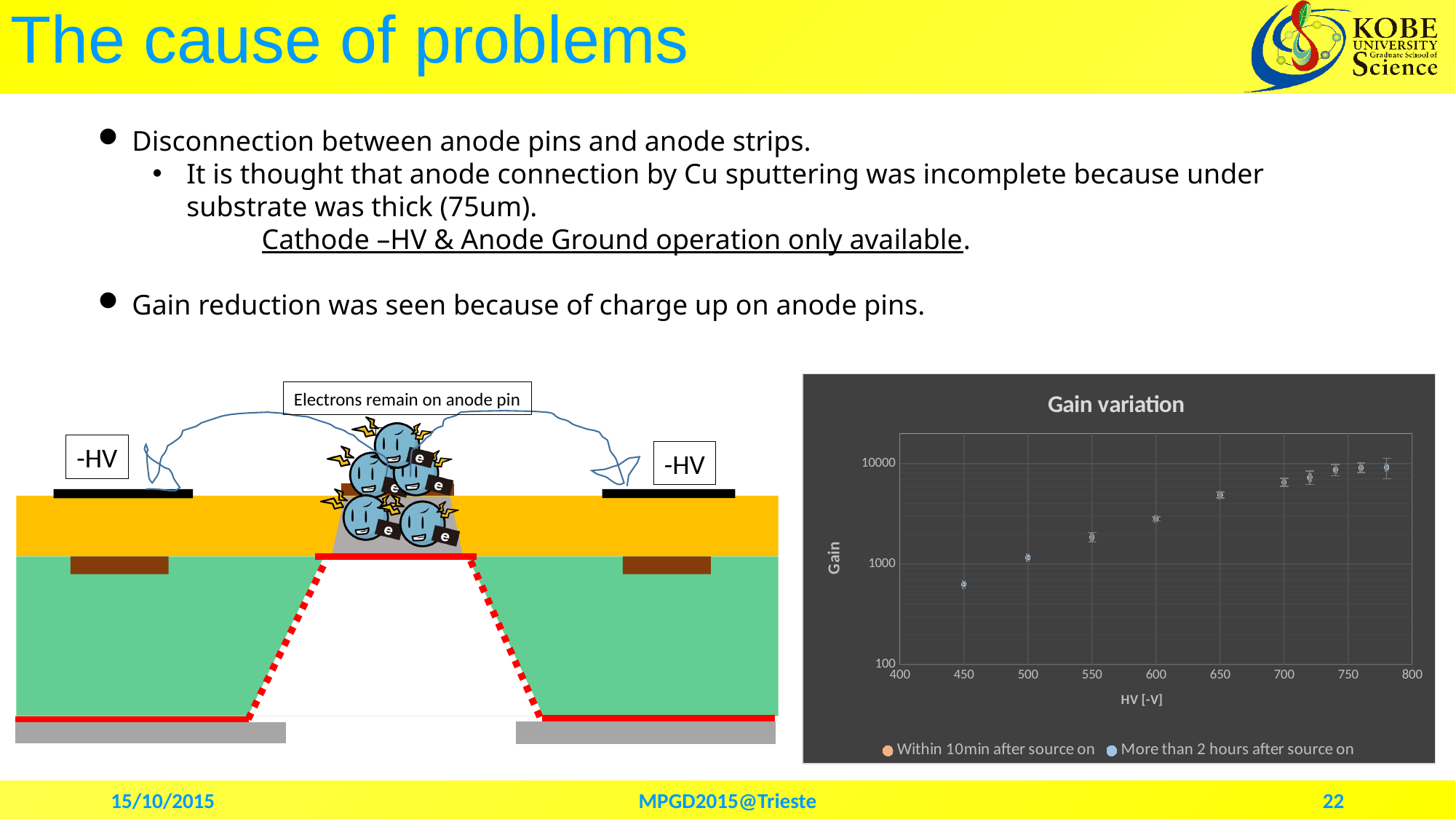
In the 'Gain variation' chart, which has the larger gain: HV 500 or HV 700? HV 700 In the 'Gain variation' chart, is the gain at HV 600 greater or less than 1000? greater In the 'Gain variation' chart, is the gain at HV 650 greater or less than 1000? greater In the 'Gain variation' chart, at which HV value is the gain lowest? 450 In the 'Gain variation' chart, is the gain at HV 550 greater or less than 10000? less What is the label of the x axis of the 'Gain variation' chart? HV [-V] How many series does the legend of the 'Gain variation' chart list? 2 In the 'Gain variation' chart, does the gain rise or fall as HV increases along the x axis? rise What is the title of the chart on the slide? Gain variation What kind of chart is the 'Gain variation' chart? scatter chart